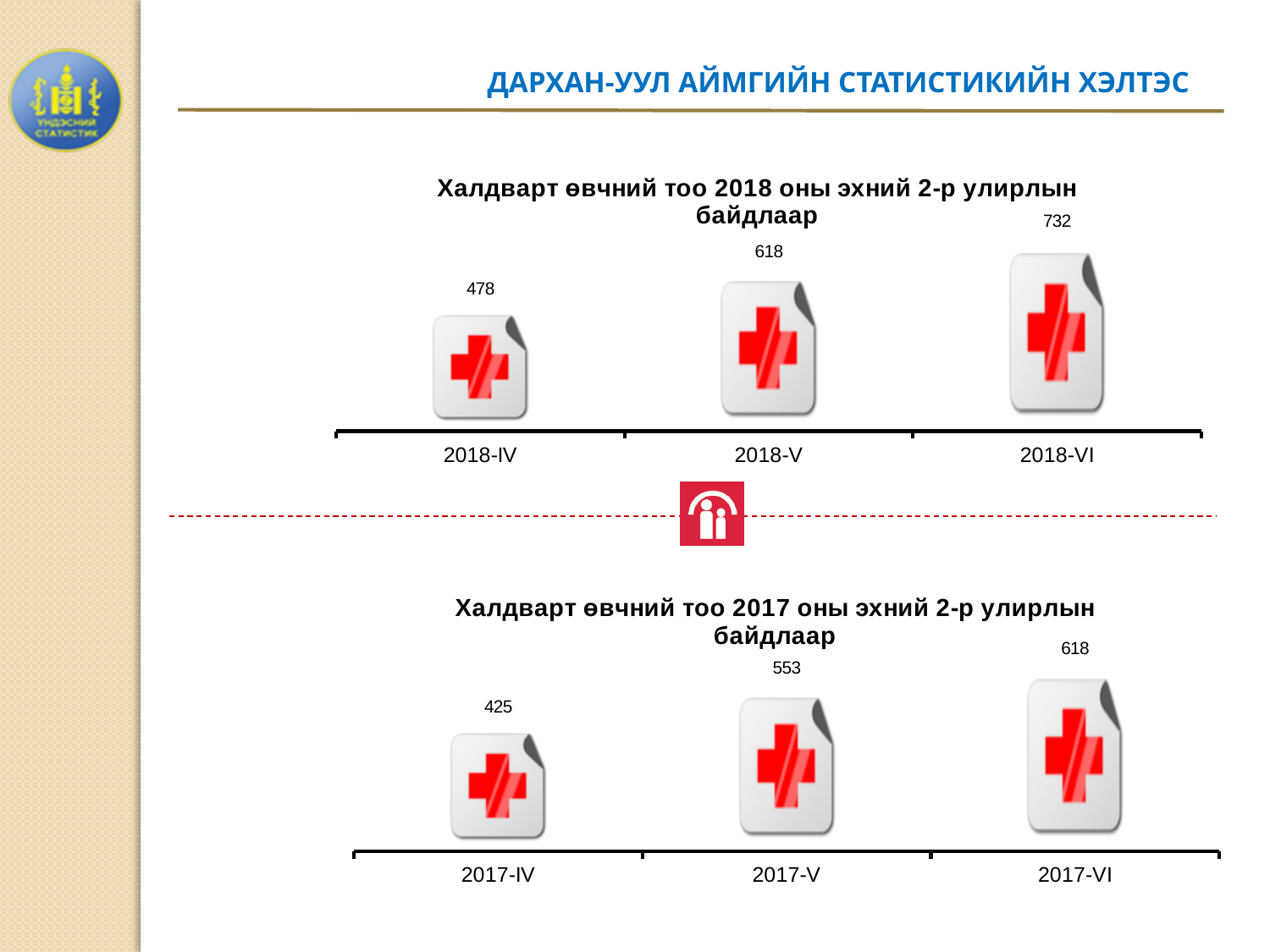
In the top chart (2018), which month has the highest value? 2018-VI In the bottom chart (2017), what is the difference between the values for 2017-V and 2017-IV? 128 In the top chart (2018), what is the value for 2018-IV? 478 How many categories are shown in the top chart (2018)? 3 Do the values in the bottom chart (2017) rise or fall from 2017-IV to 2017-VI? rise In the bottom chart (2017), which month has the lowest value? 2017-IV In the top chart (2018), what is the value for 2018-VI? 732 Which is larger: the value for 2018-V in the top chart or the value for 2017-V in the bottom chart? 2018-V What kind of chart is the top chart (2018)? bar chart In the top chart (2018), what is the difference between the values for 2018-VI and 2018-IV? 254 In the bottom chart (2017), what is the value for 2017-VI? 618 In the bottom chart (2017), what is the value for 2017-V? 553